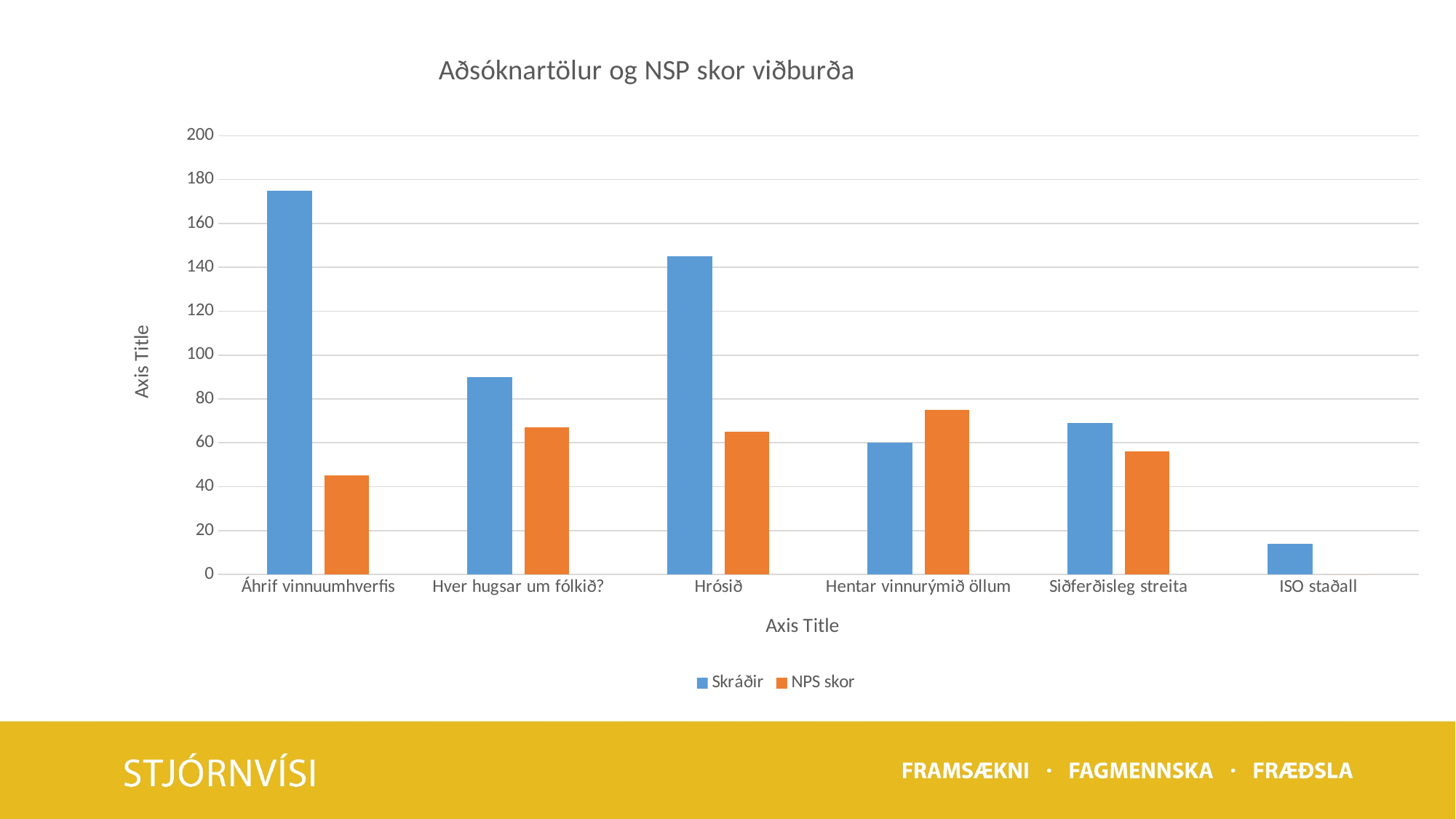
Which category has the highest NPS skor value? Hentar vinnurýmið öllum Is the Skráðir value for Hver hugsar um fólkið? greater or less than 100? less How many categories are shown on the x axis? 6 Is the Skráðir value for Áhrif vinnuumhverfis greater or less than 160? greater Which category has the highest Skráðir value? Áhrif vinnuumhverfis What type of chart is shown on the slide? bar chart For Hentar vinnurýmið öllum, which is larger: Skráðir or NPS skor? NPS skor What is the title of the chart? Aðsóknartölur og NSP skor viðburða For Hrósið, which is larger: Skráðir or NPS skor? Skráðir How many series does the legend list? 2 Is the Skráðir value for ISO staðall greater or less than 20? less Which category has the lowest Skráðir value? ISO staðall